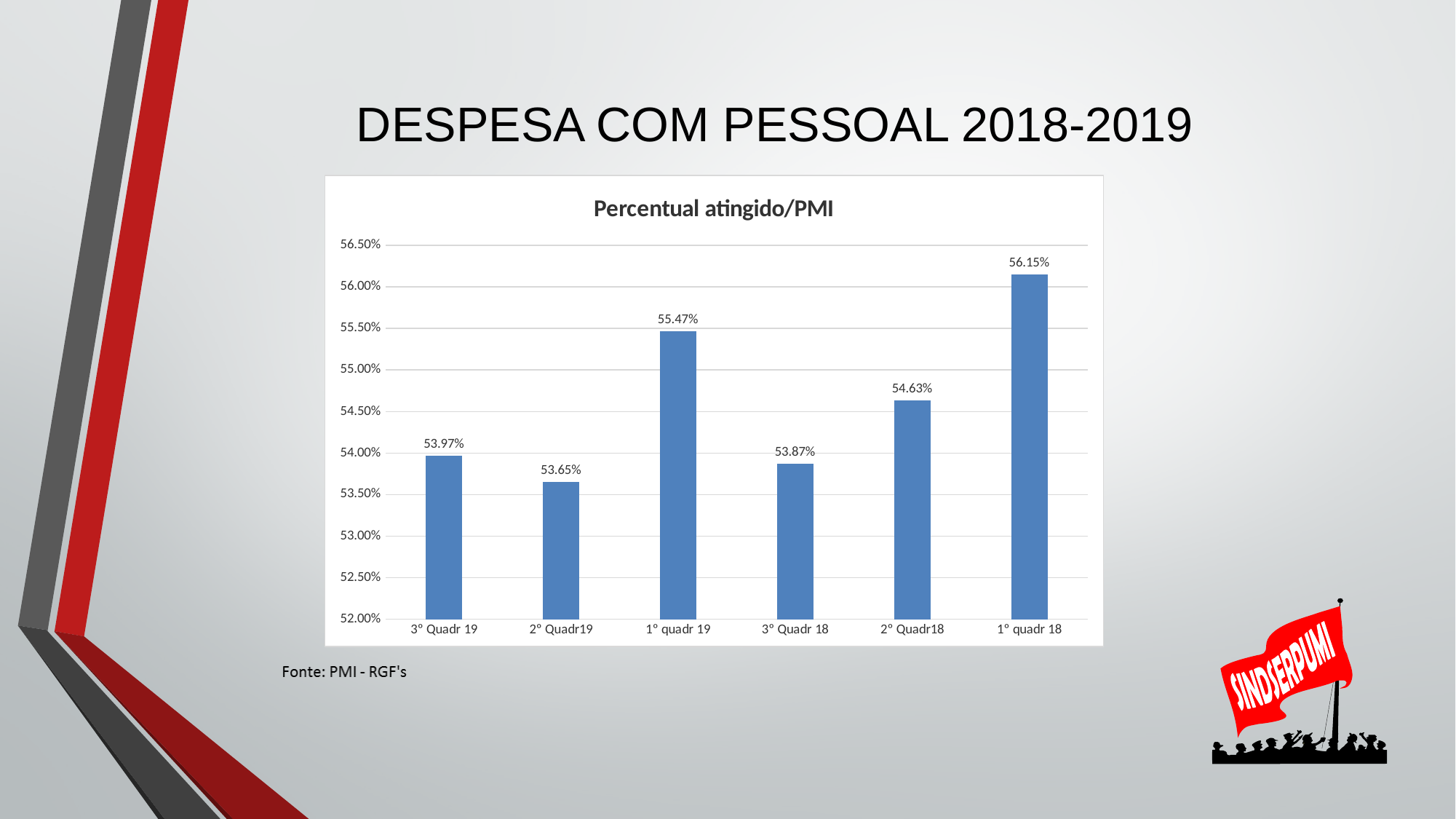
What is the value for 1° quadr 18? 56.15% What is the value for 2° Quadr18? 54.63% Is the value for 2° Quadr18 greater or less than 54.50%? greater What is the difference between the values for 1° quadr 19 and 3° Quadr 18? 1.60% Which is larger, the value for 3° Quadr 19 or the value for 3° Quadr 18? 3° Quadr 19 What is the source cited below the chart? Fonte: PMI - RGF's How many categories are shown on the x axis? 6 Which category has the highest value? 1° quadr 18 What is the title of the chart? Percentual atingido/PMI What kind of chart is shown on the slide? bar chart What is the value for 3° Quadr 19? 53.97% Which category has the lowest value? 2° Quadr19